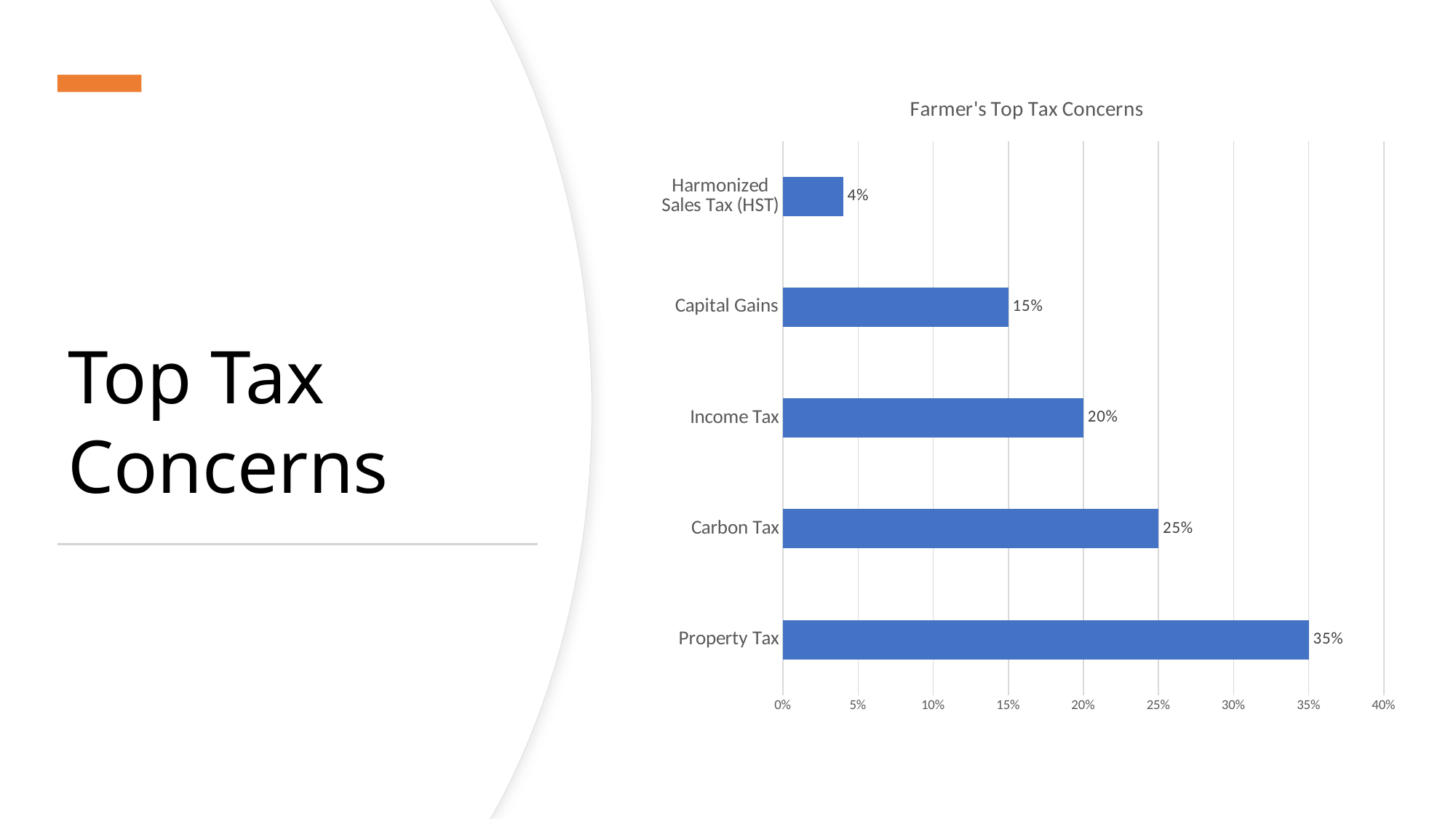
What is the value for Property Tax? 35% What is the value for Harmonized Sales Tax (HST)? 4% What kind of chart is shown on the slide? bar chart Which category has the highest value? Property Tax What is the difference between the values for Property Tax and Income Tax? 15% What is the value for Carbon Tax? 25% Is the value for Income Tax greater or less than 10%? greater Which is larger, the value for Carbon Tax or the value for Capital Gains? Carbon Tax What is the value for Capital Gains? 15% What is the title of the chart? Farmer's Top Tax Concerns Which category has the lowest value? Harmonized Sales Tax (HST) How many categories are shown in the chart? 5